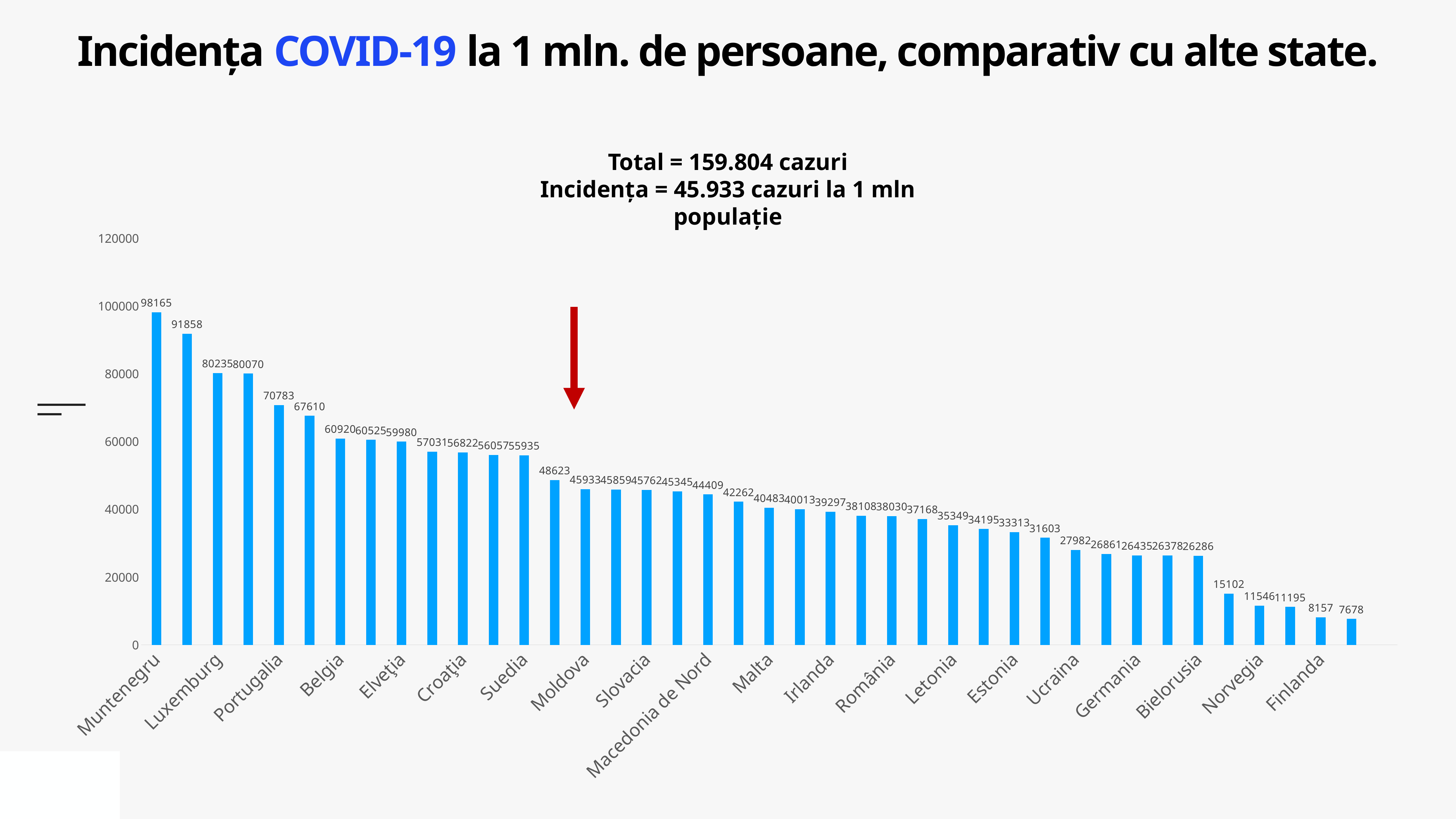
Is the value for Norvegia greater or less than 20000? less How many bars are plotted in the chart? 40 Which country has the highest incidence in the chart? Muntenegru What is the incidence value shown for Moldova? 45933 Which has a higher incidence, Muntenegru or Moldova? Muntenegru Is the value for Luxemburg greater or less than 60000? greater What kind of chart is shown on the slide? bar chart Do the values rise or fall from left to right along the x axis? fall What is the incidence value shown for Muntenegru? 98165 What is the title of the slide? Incidența COVID-19 la 1 mln. de persoane, comparativ cu alte state. What is the difference between the values for Muntenegru and Moldova? 52232 Is the value for Finlanda greater or less than 20000? less